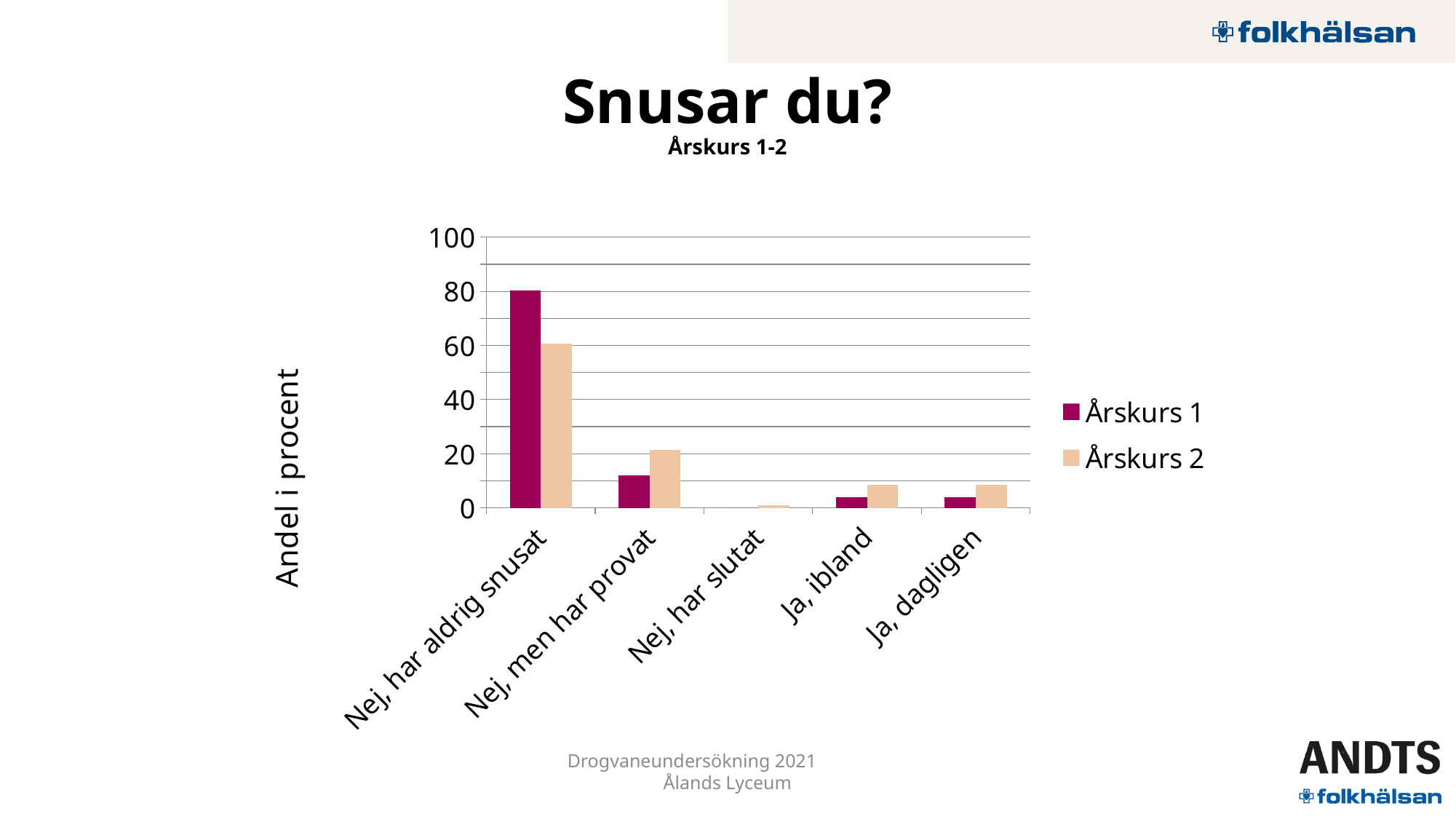
For 'Nej, men har provat', which series has the larger value, Årskurs 1 or Årskurs 2? Årskurs 2 How many series does the legend list? 2 Is the value for Årskurs 2 in 'Nej, men har provat' greater or less than 40? less What is the title of the chart? Snusar du? Which category has the highest value for Årskurs 2? Nej, har aldrig snusat Is the value for Årskurs 1 in 'Nej, har aldrig snusat' greater or less than 60? greater What kind of chart is shown on the slide? bar chart How many categories are shown on the x axis? 5 Which category has the highest value for Årskurs 1? Nej, har aldrig snusat For 'Nej, har aldrig snusat', which series has the larger value, Årskurs 1 or Årskurs 2? Årskurs 1 What is the label on the y axis? Andel i procent Which category has the lowest value for Årskurs 1? Nej, har slutat